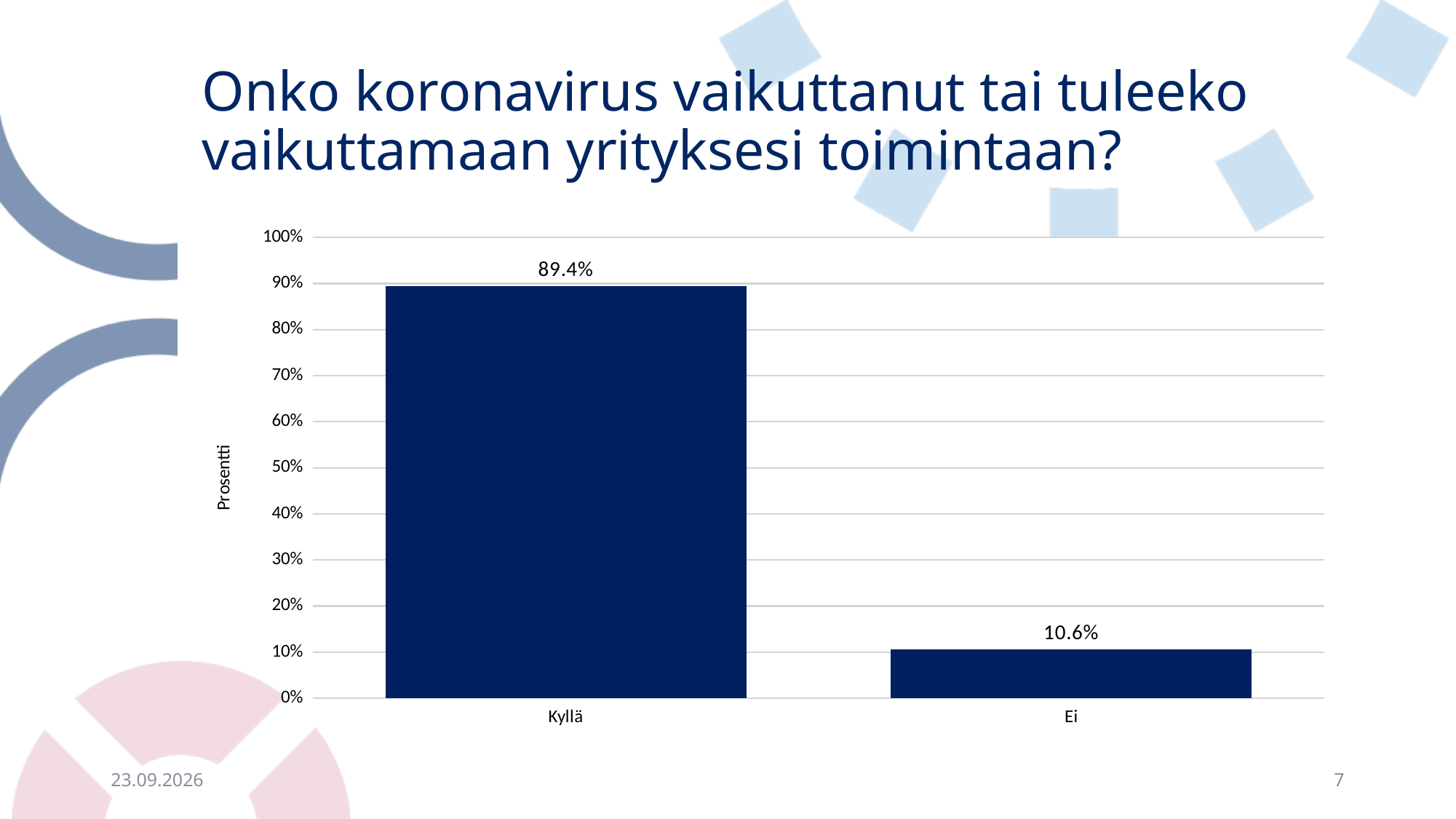
Which category has the highest value? Kyllä What is the highest value shown on the vertical axis? 100% What is the difference between the values for Kyllä and Ei? 78.8% Which category has the lowest value? Ei What is the value for Kyllä? 89.4% What is the value for Ei? 10.6% Is the value for Kyllä greater or less than 80%? greater Is the value for Ei greater or less than 20%? less Which is larger, the value for Kyllä or the value for Ei? Kyllä What kind of chart is shown on the slide? bar chart How many categories are shown on the x axis? 2 What is the label of the vertical axis? Prosentti